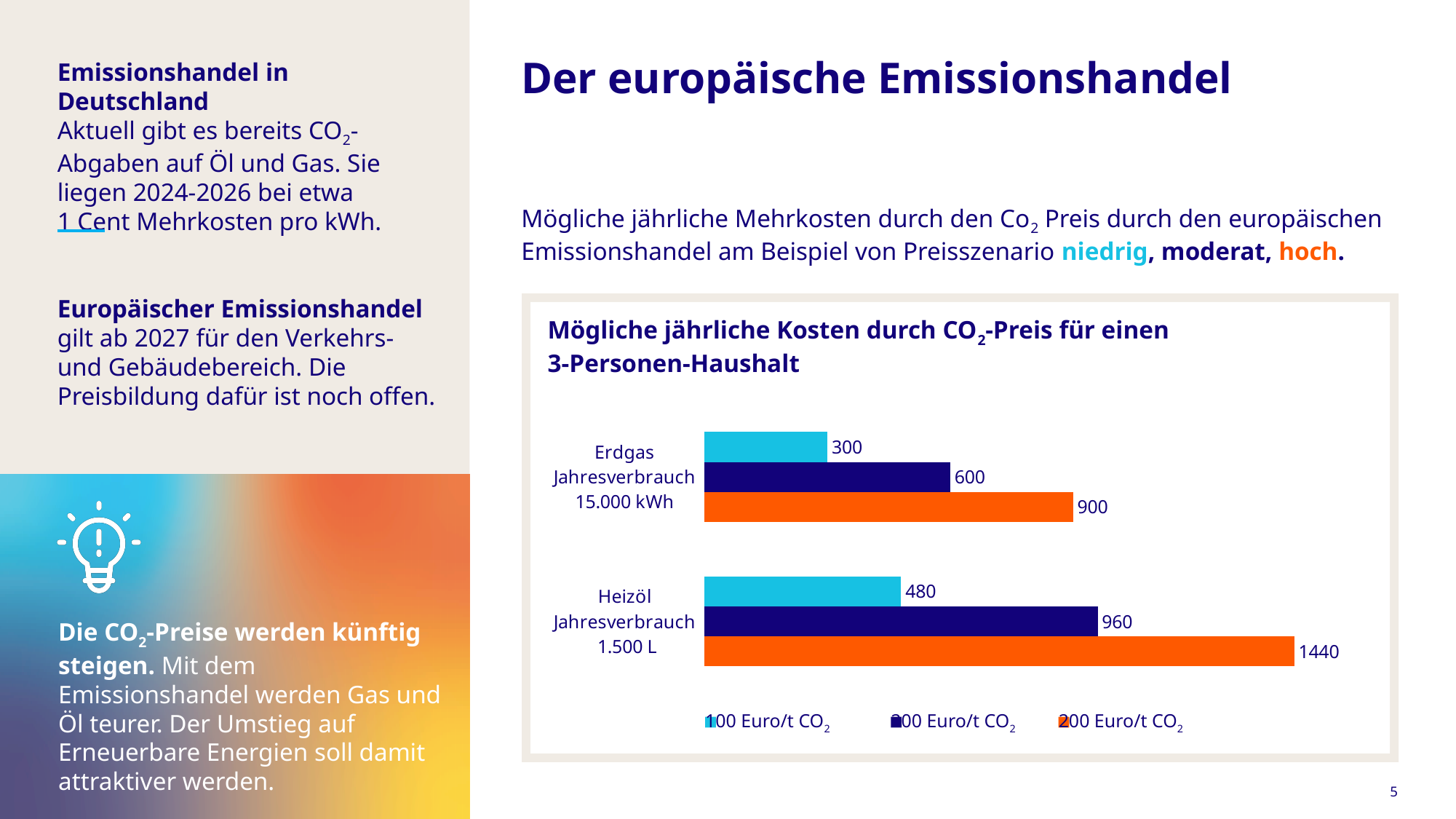
What type of chart is shown on the slide? Bar chart How much higher is the hoch (orange) scenario cost for Heizöl than for Erdgas? 540 Which bar shows the lowest annual cost in the chart? Erdgas, niedrig (light blue) scenario: 300 What is the difference between the niedrig (light blue) scenario costs for Heizöl and Erdgas? 180 What is the annual cost for Erdgas (Jahresverbrauch 15.000 kWh) in the niedrig (light blue) price scenario? 300 Which is larger: the moderat (dark blue) cost for Erdgas or the niedrig (light blue) cost for Heizöl? The moderat cost for Erdgas (600) What is the annual cost for Heizöl (Jahresverbrauch 1.500 L) in the hoch (orange) price scenario? 1440 What is the annual cost for Erdgas (Jahresverbrauch 15.000 kWh) in the hoch (orange) price scenario? 900 How many categories (fuel types) are shown in the chart? 2 What is the annual cost for Heizöl (Jahresverbrauch 1.500 L) in the moderat (dark blue) price scenario? 960 Which bar shows the highest annual cost in the chart? Heizöl, hoch (orange) scenario: 1440 How many series does the chart's legend list? 3